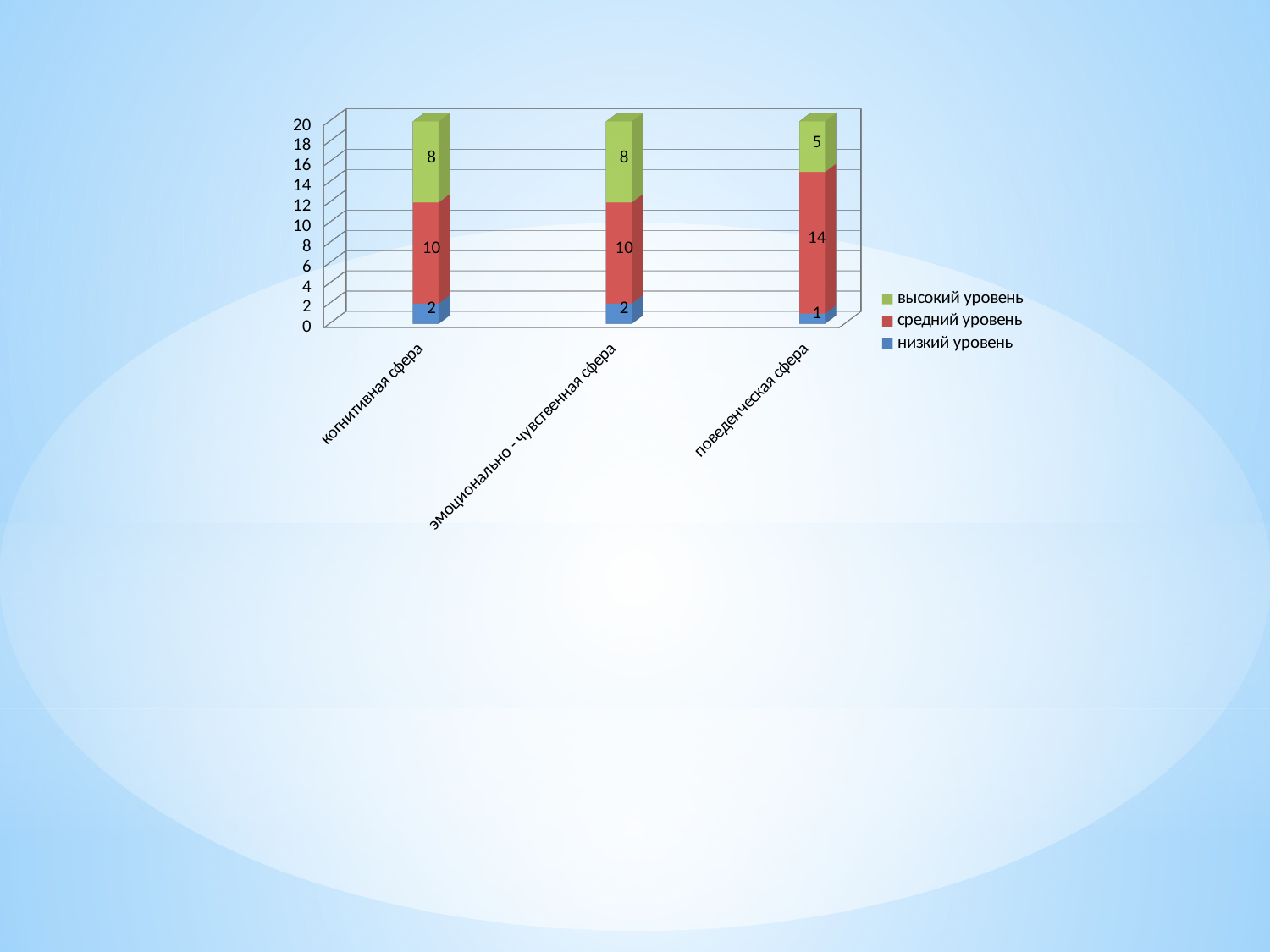
Which category has the lowest value for 'высокий уровень'? поведенческая сфера What is the value of 'высокий уровень' for 'когнитивная сфера'? 8 Which colour represents 'низкий уровень' in the chart? blue What is the value of 'средний уровень' for 'эмоционально - чувственная сфера'? 10 Which category has the highest value for 'средний уровень'? поведенческая сфера What is the value of 'низкий уровень' for 'поведенческая сфера'? 1 How many series does the chart's legend list? 3 What is the difference between the 'средний уровень' values for 'поведенческая сфера' and 'когнитивная сфера'? 4 What is the value of 'средний уровень' for 'поведенческая сфера'? 14 What kind of chart is shown on the slide? stacked bar chart How many categories are shown on the x axis of the chart? 3 What is the total of the stacked bar for 'поведенческая сфера'? 20